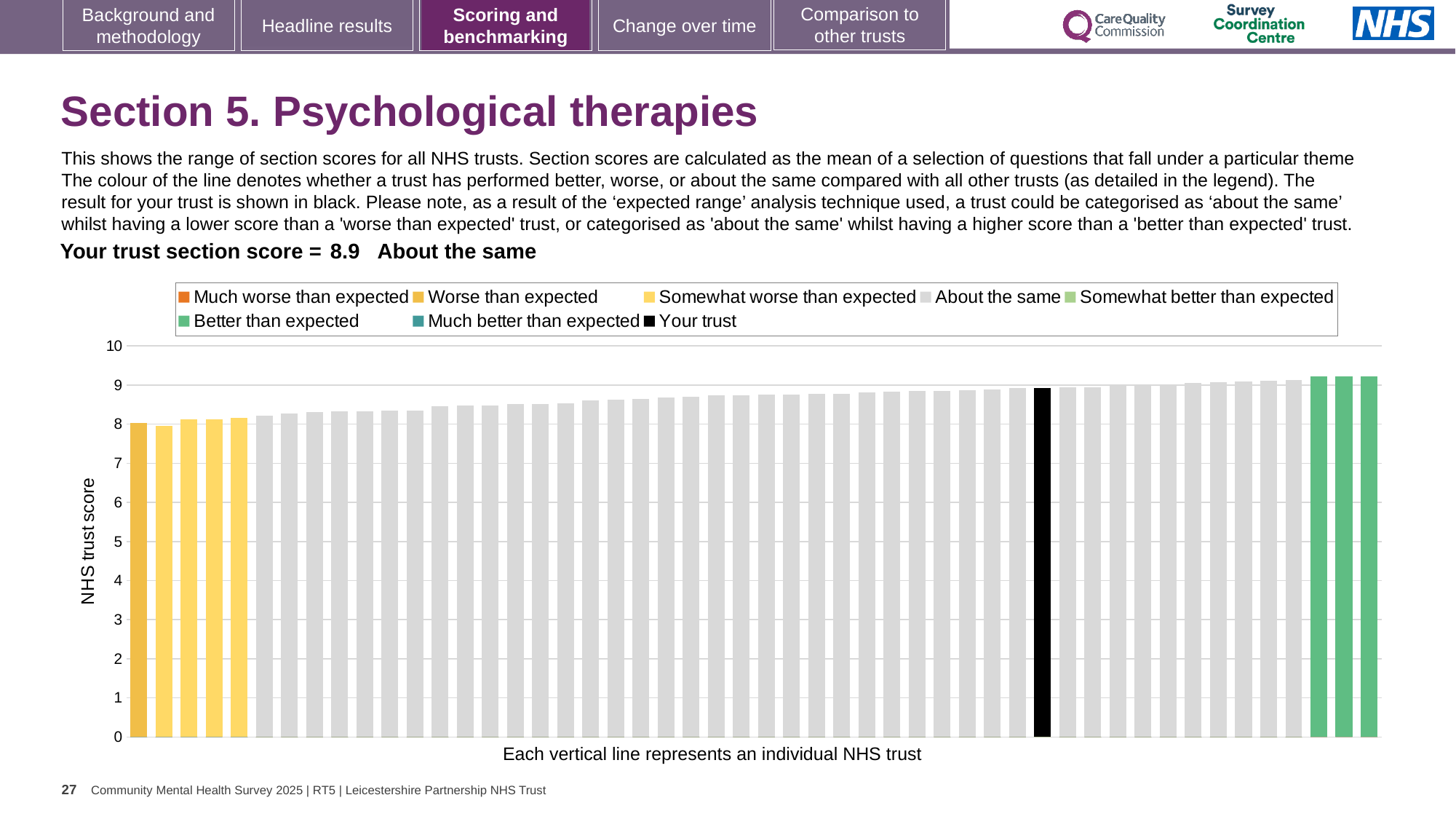
Is the value for the leftmost bar greater or less than 7? greater Do the bar values rise or fall from left to right along the x axis? rise Is the value for your trust (the black bar) greater or less than 8? greater Is the value for the leftmost bar greater or less than 9? less Which is larger: the value for your trust (black bar) or the value for the leftmost bar? Your trust How many entries does the chart legend list? 8 What is the label on the vertical axis of the chart? NHS trust score What is the section score for your trust shown on the slide? 8.9 Which performance category is your trust placed in for this section? About the same How many bars are coloured green (Better than expected)? 3 What kind of chart is shown on the slide? Bar chart